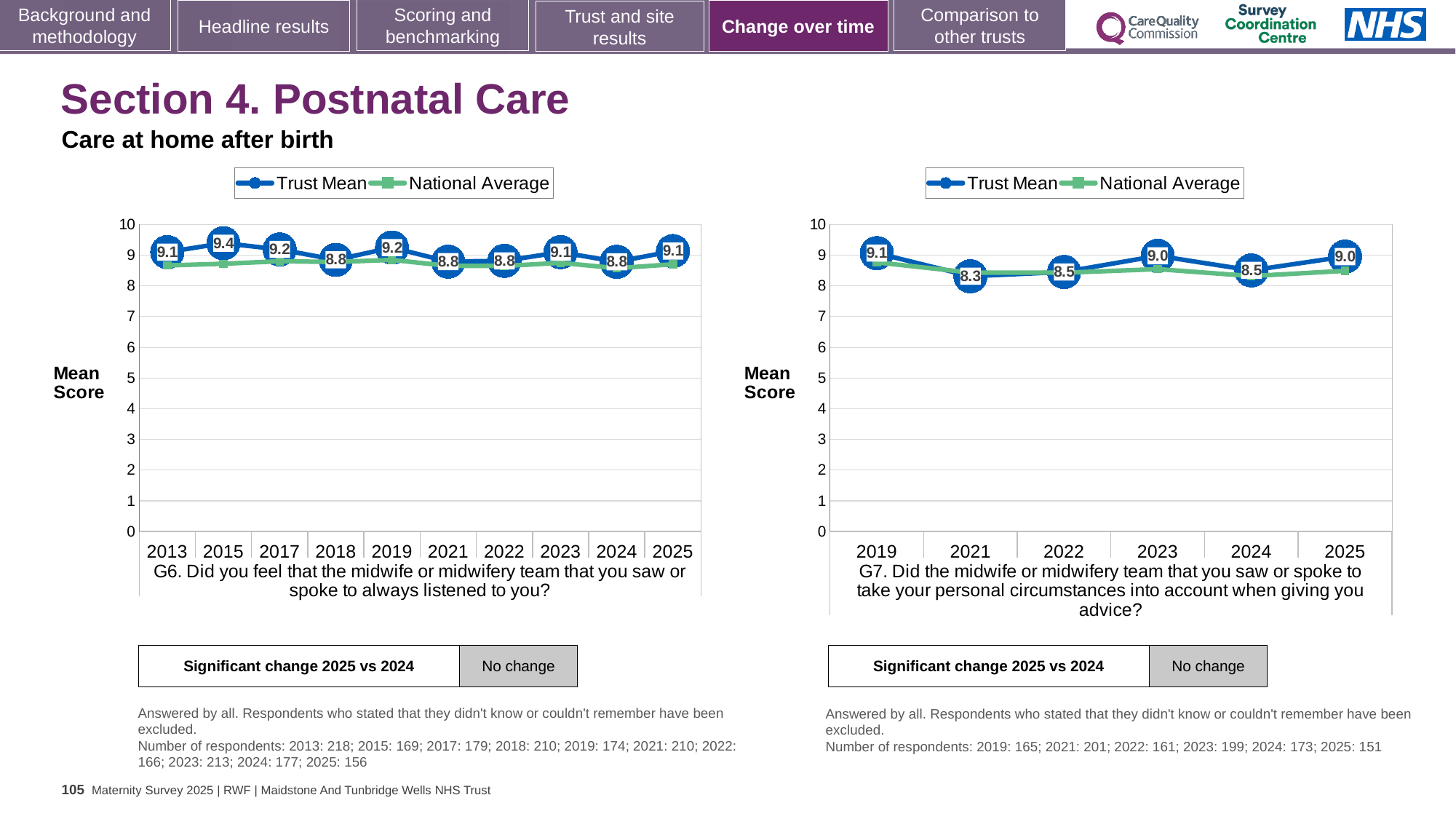
In the G7 chart on the right, which year has the lowest Trust Mean? 2021 In the G6 chart on the left, what is the Trust Mean for 2025? 9.1 In the G7 chart on the right, is the National Average for 2025 greater or less than 8? greater How many years are shown on the x axis of the G6 chart on the left? 10 What type of chart is the G6 chart on the left? Line chart In the G6 chart on the left, what is the Trust Mean for 2015? 9.4 In the G6 chart on the left, which year has the highest Trust Mean? 2015 In the G7 chart on the right, what is the Trust Mean for 2021? 8.3 How many series does the legend of the G7 chart on the right list? 2 In the G7 chart on the right, what is the Trust Mean for 2025? 9.0 In the G7 chart on the right, what is the difference between the Trust Mean for 2019 and the Trust Mean for 2021? 0.8 In the G6 chart on the left, is the Trust Mean higher in 2015 or in 2018? 2015